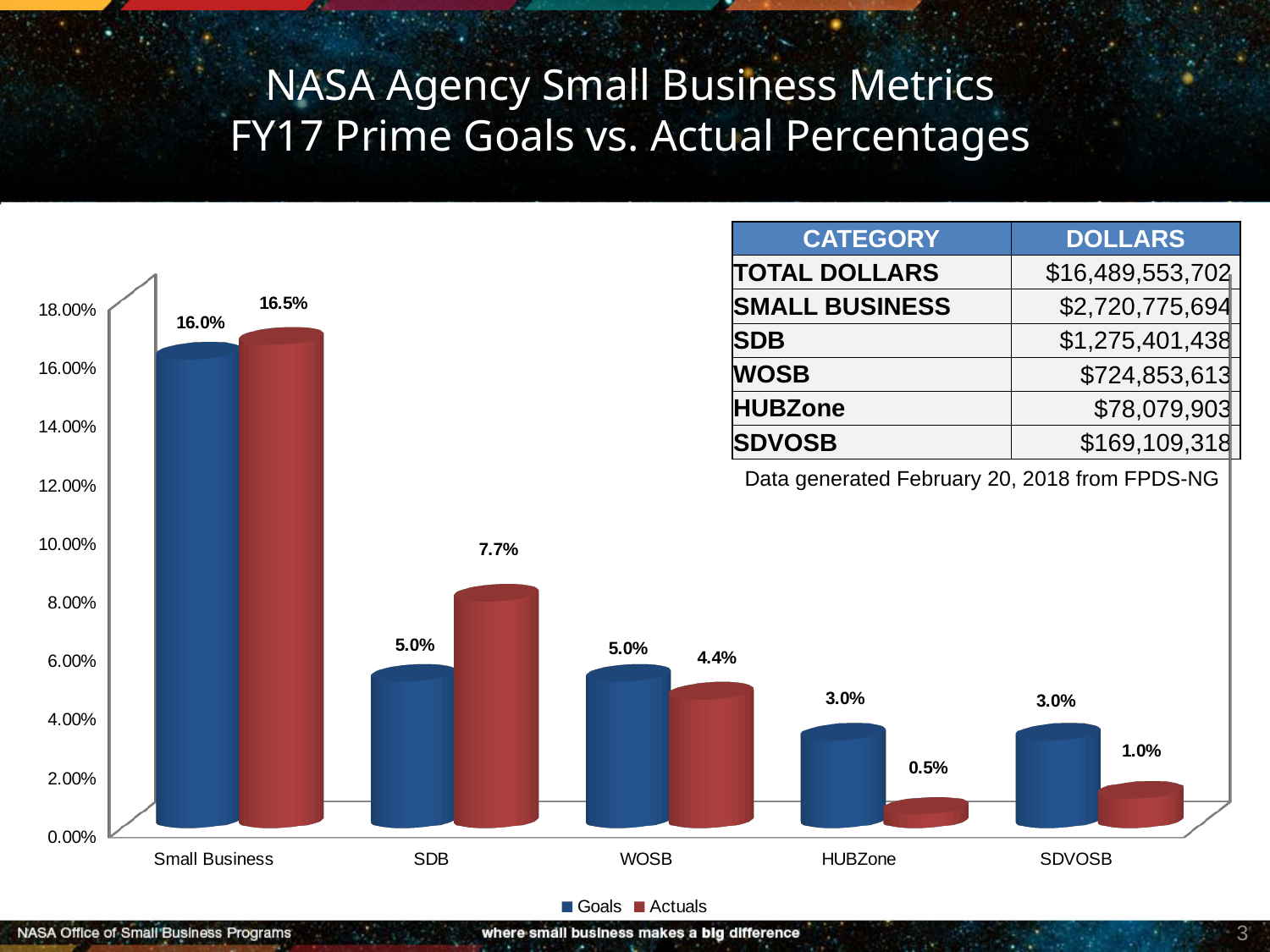
What is the difference between the Actuals and Goals values for SDB? 2.7% What is the Actuals value for Small Business? 16.5% Which category has the lowest Actuals value? HUBZone Is the Actuals value for SDVOSB greater or less than 2.00%? less Which is larger for WOSB, the Goals value or the Actuals value? Goals What is the Goals value for HUBZone? 3.0% What is the Actuals value for SDB? 7.7% How many series does the chart legend list? 2 What are the two series named in the chart legend? Goals and Actuals Which category has the highest Actuals value? Small Business How many categories are shown on the x axis of the chart? 5 What kind of chart is shown on the slide? bar chart